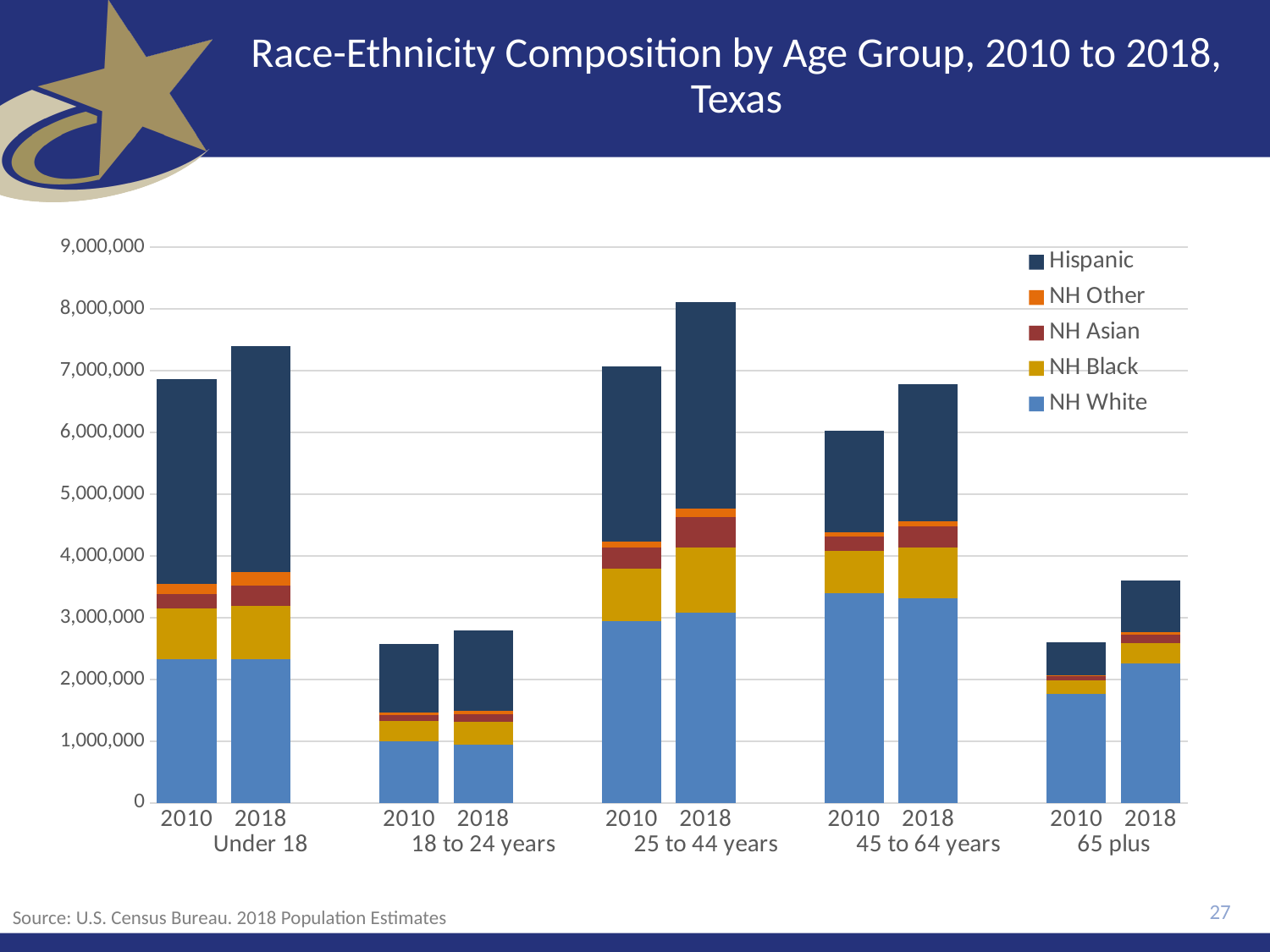
Is the total for Under 18 in 2018 greater or less than 7,000,000? greater Which bar has the highest total population? 25 to 44 years, 2018 Is the total for 65 plus in 2018 greater or less than 3,000,000? greater How many age groups are shown along the x axis? 5 What kind of chart is shown on the slide? Stacked bar chart How many bars are plotted in the chart? 10 Is the total for 18 to 24 years in 2010 greater or less than 3,000,000? less Which series forms the bottom segment of each stacked bar? NH White Which is larger, the 2018 total for Under 18 or the 2018 total for 25 to 44 years? 25 to 44 years Among the 2018 bars, which age group has the lowest total? 18 to 24 years Does the total for the 65 plus age group rise or fall from 2010 to 2018? Rise How many series does the legend list? 5